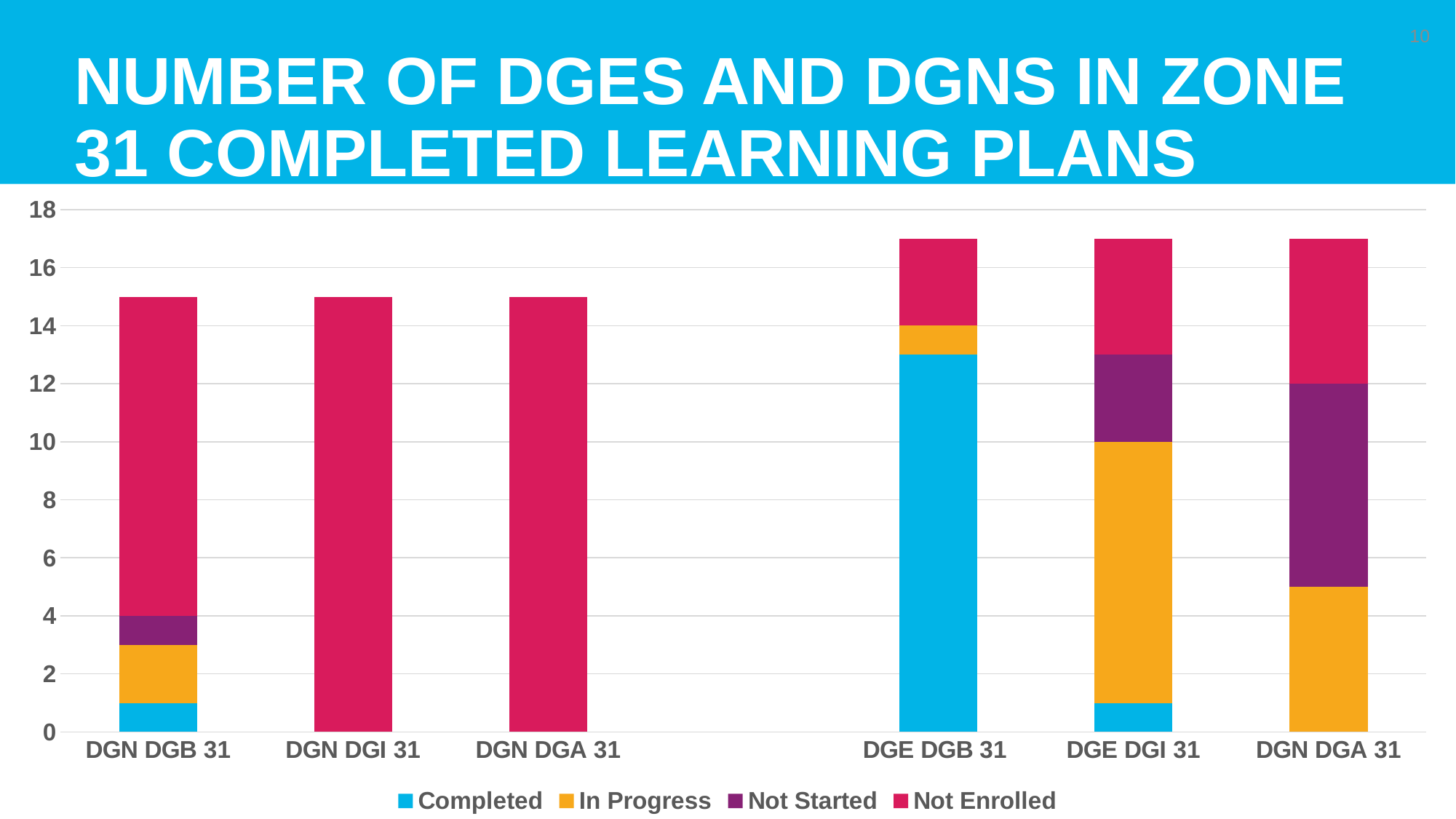
Which category has the largest Completed segment? DGE DGB 31 What kind of chart is shown on the slide? Stacked bar chart Is the total for DGE DGI 31 greater or less than 16? greater Which colour represents the Not Enrolled series? Red/pink Is the total for DGN DGB 31 greater or less than 14? greater Which series does the legend list first? Completed How many series does the legend list? 4 Is the Completed value for DGE DGB 31 greater or less than 12? greater Which is larger, the Not Started segment for the rightmost bar or the Not Started segment for DGE DGI 31? The rightmost bar How many categories are shown on the x axis? 6 Which is larger, the total for DGE DGB 31 or the total for DGN DGB 31? DGE DGB 31